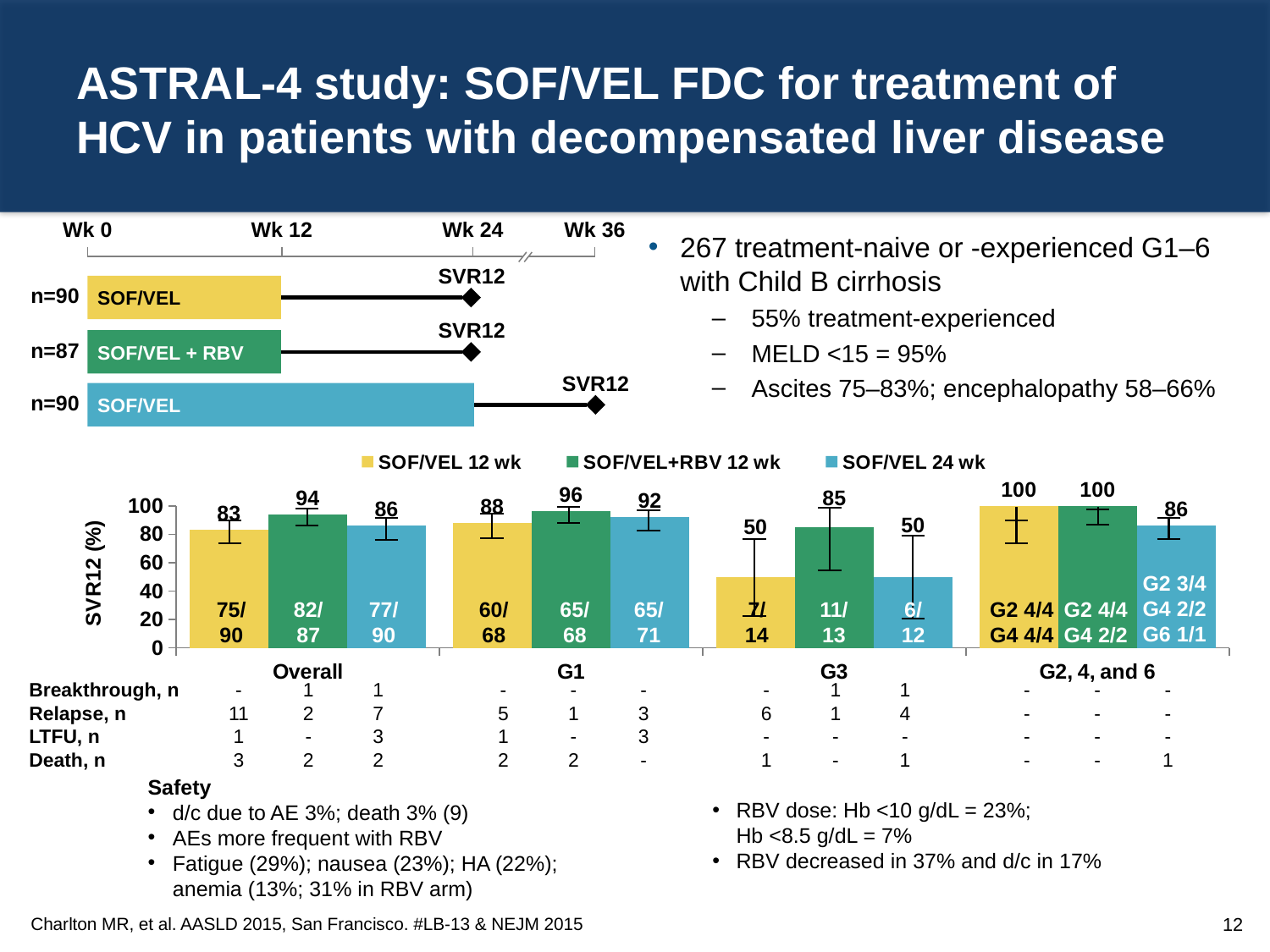
What is the SVR12 (%) for SOF/VEL 24 wk in the G2, 4, and 6 group? 86 What is the difference in SVR12 (%) between SOF/VEL+RBV 12 wk and SOF/VEL 12 wk in the Overall group? 11 What is the SVR12 (%) for SOF/VEL+RBV 12 wk in the Overall group? 94 Which genotype group has the lowest SVR12 (%) for SOF/VEL 12 wk? G3 Which series has the highest SVR12 (%) in the G3 group? SOF/VEL+RBV 12 wk How many series does the legend of the SVR12 chart list? 3 How many genotype groups are shown on the x axis of the SVR12 chart? 4 Which is larger in the G1 group: the SVR12 (%) for SOF/VEL 12 wk or for SOF/VEL 24 wk? SOF/VEL 24 wk What is the SVR12 (%) for SOF/VEL 12 wk in the G3 group? 50 What is the label of the y axis of the SVR12 chart? SVR12 (%) What is the SVR12 (%) for SOF/VEL 24 wk in the G1 group? 92 What kind of chart is used to show the SVR12 (%) results? Bar chart